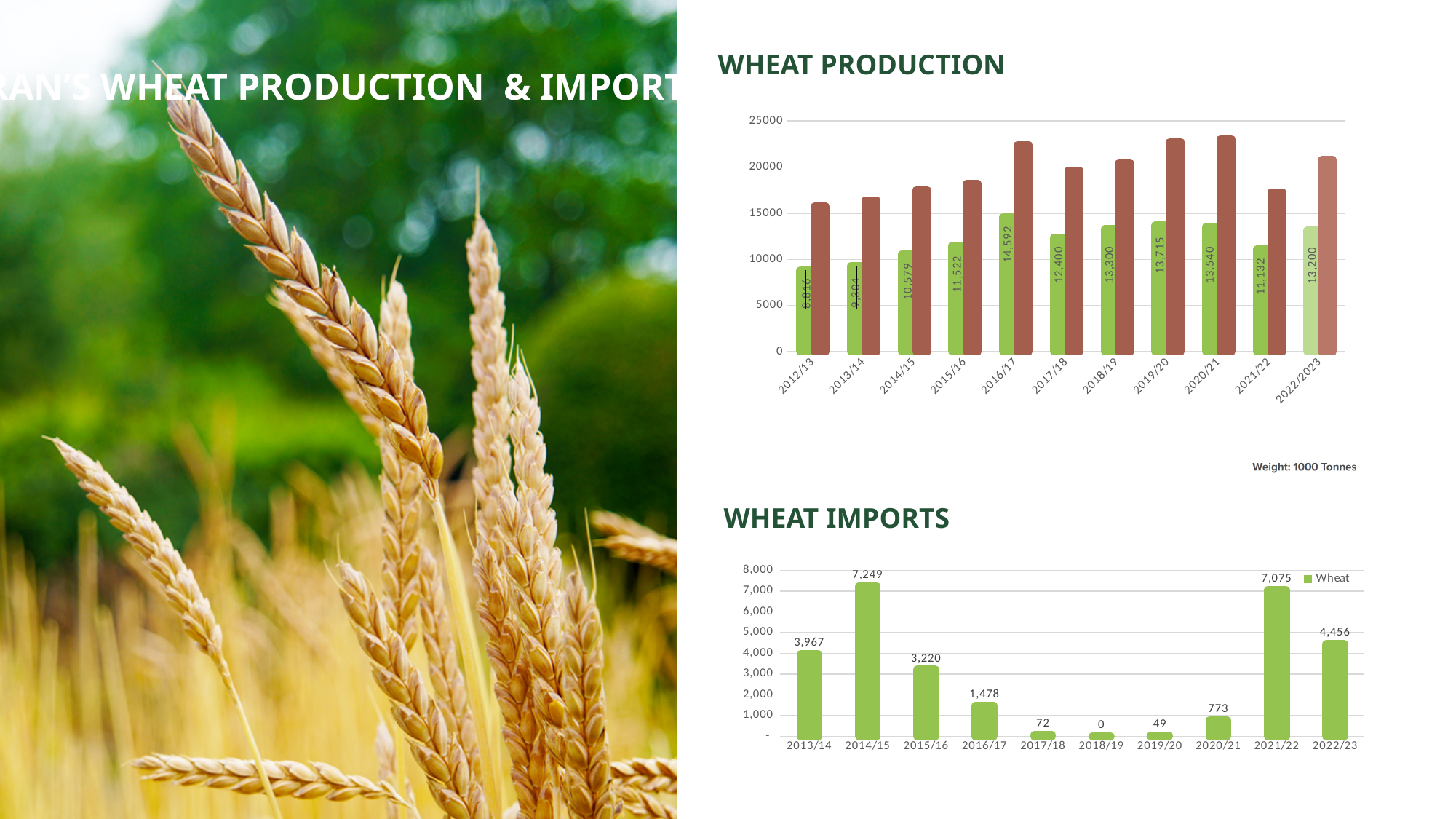
How many series does the legend of the Wheat Imports chart list? 1 How many years are shown on the x axis of the Wheat Production chart? 11 What kind of chart is the Wheat Imports chart? bar chart How many years are shown on the x axis of the Wheat Imports chart? 10 In the Wheat Imports chart, what is the value for 2020/21? 773 In the Wheat Production chart, is the brown bar for 2020/21 greater or less than 20000? greater In the Wheat Imports chart, which is larger, the value for 2013/14 or the value for 2015/16? 2013/14 In the Wheat Imports chart, which year has the highest imports? 2014/15 In the Wheat Imports chart, which year has the lowest imports? 2018/19 In the Wheat Imports chart, what is the difference between the values for 2021/22 and 2022/23? 2,619 In the Wheat Imports chart, what is the value for 2014/15? 7,249 In the Wheat Production chart, is the green bar for 2012/13 greater or less than 10000? less